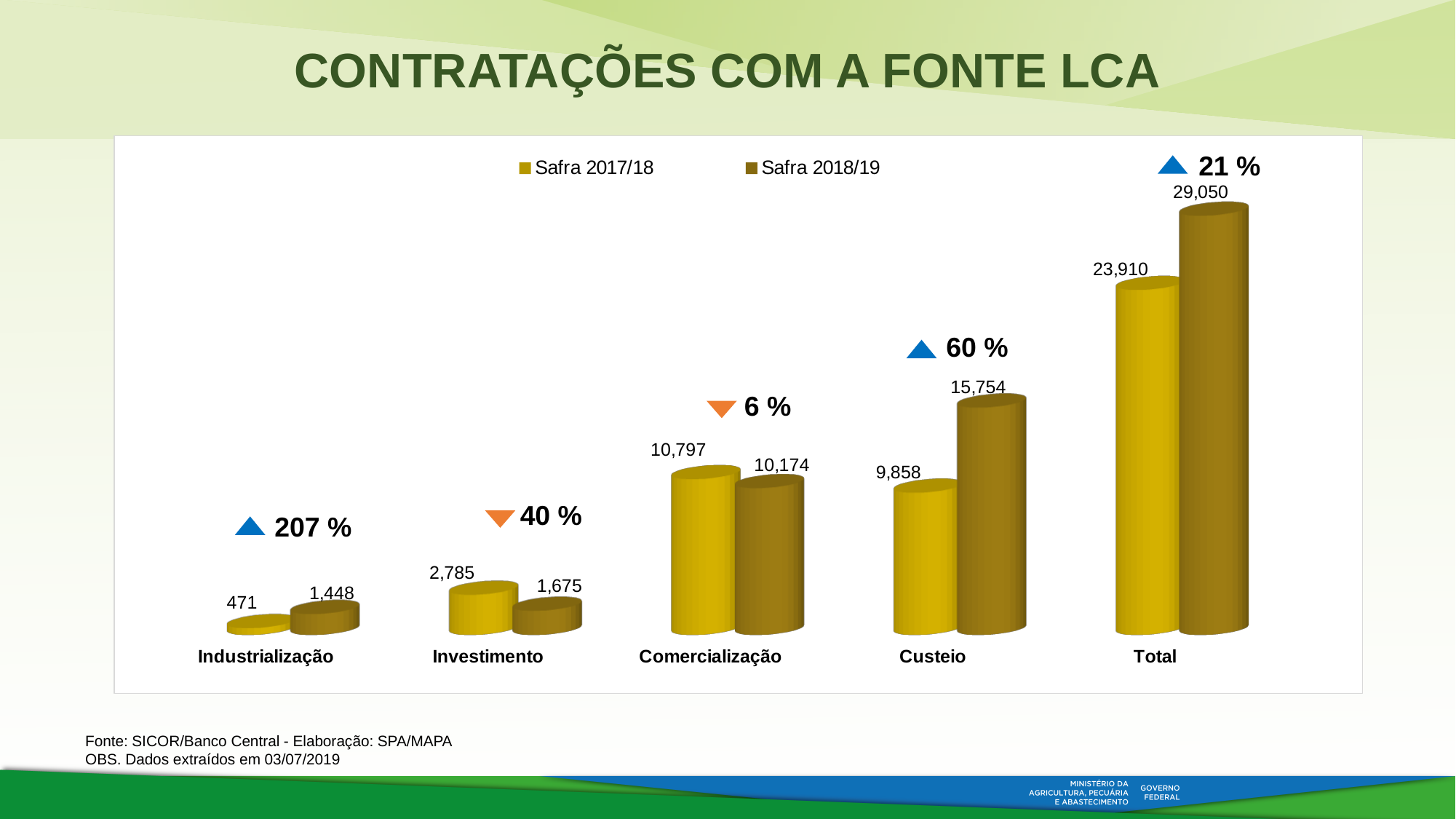
How many categories are shown on the x axis? 5 What percentage change is shown above the Industrialização bars? 207 % What is the value for Industrialização in the Safra 2017/18 series? 471 For Investimento, which series has the larger value, Safra 2017/18 or Safra 2018/19? Safra 2017/18 Which category has the highest value in the Safra 2018/19 series? Total What is the difference between the Safra 2018/19 and Safra 2017/18 values for Custeio? 5,896 How many series does the legend list? 2 What is the difference between the Safra 2017/18 and Safra 2018/19 values for Investimento? 1,110 What is the value for Custeio in the Safra 2018/19 series? 15,754 What is the value for Comercialização in the Safra 2018/19 series? 10,174 What kind of chart is shown on the slide? Bar chart Excluding Total, which category has the lowest value in the Safra 2017/18 series? Industrialização